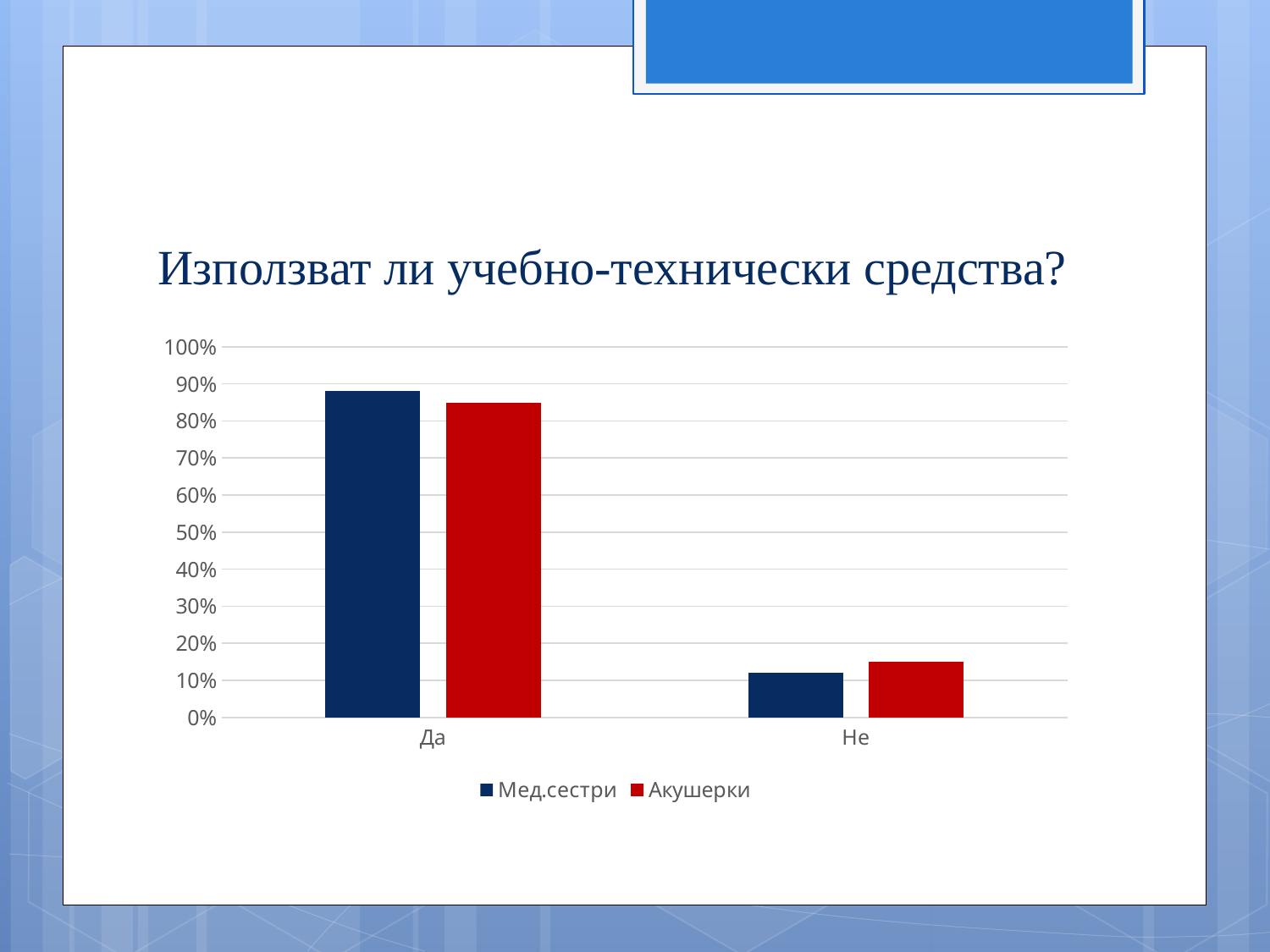
How many categories are shown on the x axis? 2 Is the value for Акушерки in the Да category greater or less than 80%? greater What kind of chart is shown on the slide? bar chart In the Не category, which series has the larger value, Мед.сестри or Акушерки? Акушерки What is the title of the chart? Използват ли учебно-технически средства? Is the value for Акушерки in the Не category greater or less than 10%? greater For the Акушерки series, which category has the lowest value? Не Is the value for Мед.сестри in the Да category greater or less than 80%? greater Which series is shown in red in the legend? Акушерки For the Мед.сестри series, which category has the highest value? Да How many series does the legend list? 2